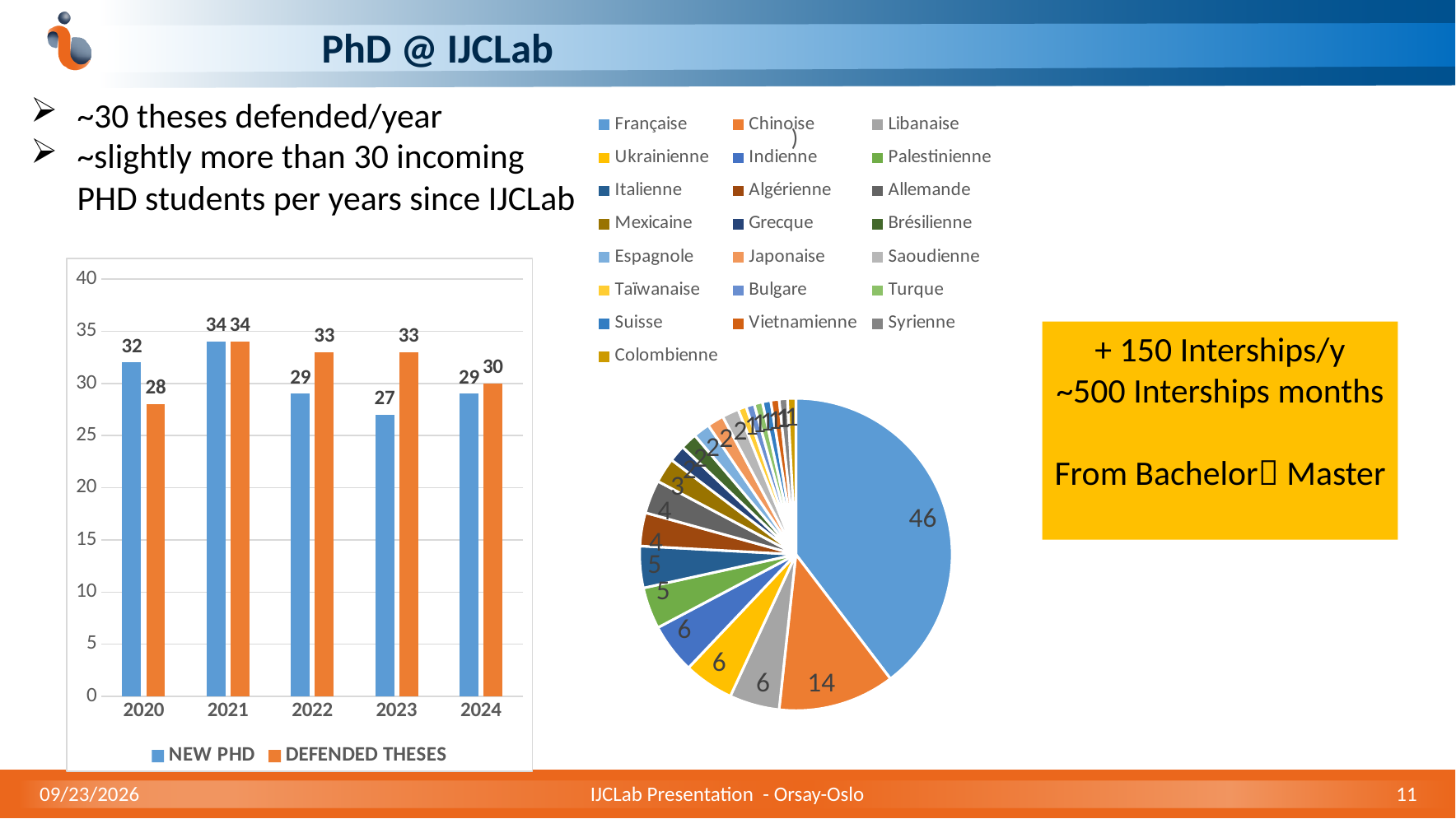
In the bar chart, what is the NEW PHD value for 2020? 32 In the pie chart, what is the value for Chinoise? 14 In the pie chart, which nationality has the largest slice? Française In the bar chart, which series has the larger value in 2022, NEW PHD or DEFENDED THESES? DEFENDED THESES How many series does the legend of the bar chart list? 2 In the pie chart, what is the value for Française? 46 In the bar chart, which year has the lowest NEW PHD value? 2023 In the bar chart, what is the difference between NEW PHD and DEFENDED THESES in 2020? 4 How many years are shown on the x axis of the bar chart? 5 In the bar chart, which year has the highest NEW PHD value? 2021 In the bar chart, what is the DEFENDED THESES value for 2023? 33 What kind of chart is the chart on the left of the slide? bar chart